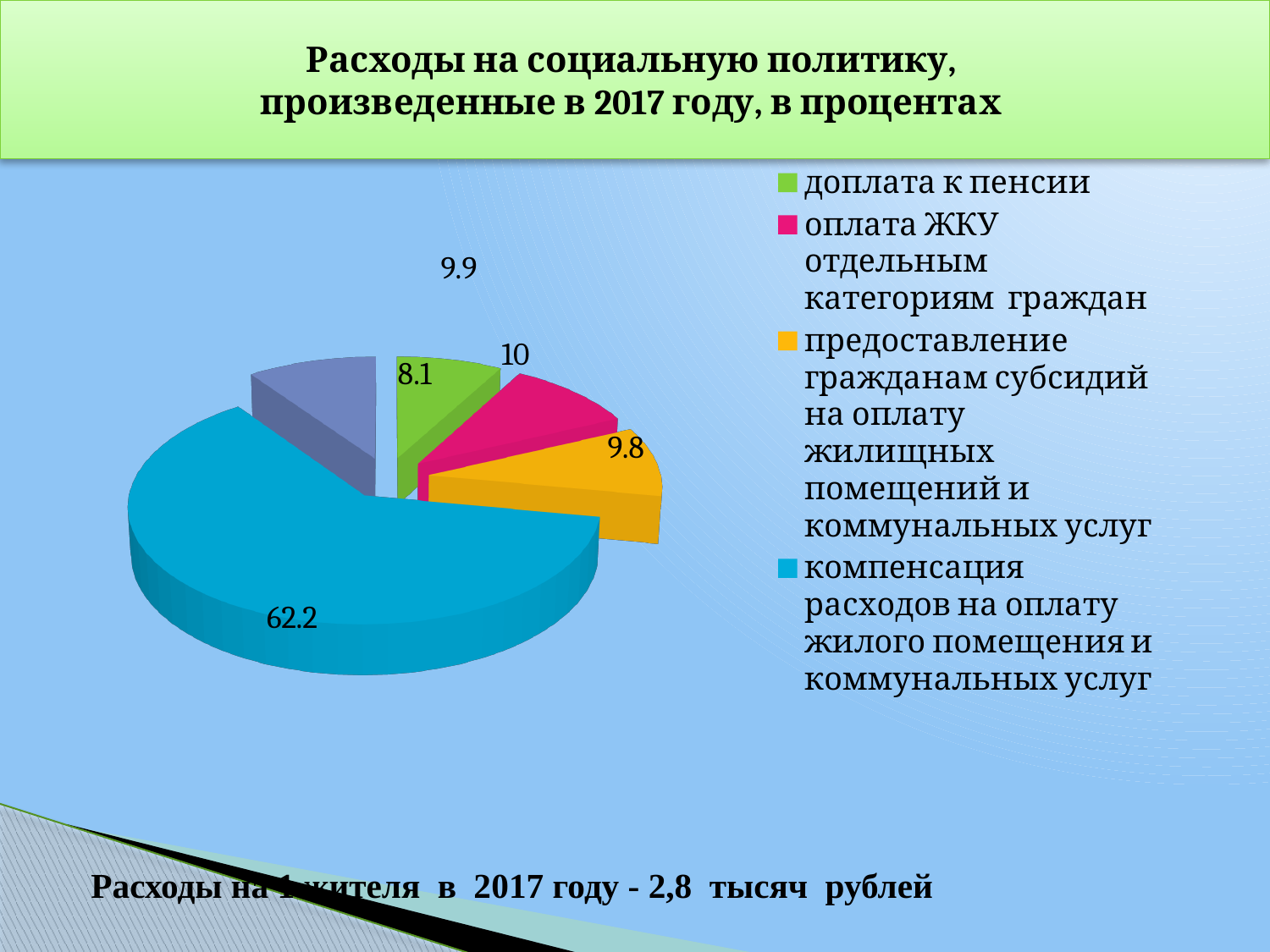
What is the value for оплата ЖКУ отдельным категориям граждан? 10 How many entries does the legend list? 4 How many slices does the pie chart have? 5 Which category has the largest slice of the pie? компенсация расходов на оплату жилого помещения и коммунальных услуг What is the value for предоставление гражданам субсидий на оплату жилищных помещений и коммунальных услуг? 9.8 What kind of chart is shown on the slide? pie chart Which category has the smallest slice of the pie? доплата к пенсии Which is larger: the value for оплата ЖКУ отдельным категориям граждан or the value for доплата к пенсии? оплата ЖКУ отдельным категориям граждан What is the value for компенсация расходов на оплату жилого помещения и коммунальных услуг? 62.2 What colour is the slice for доплата к пенсии? green What is the difference between the values for компенсация расходов на оплату жилого помещения и коммунальных услуг and доплата к пенсии? 54.1 What is the value for доплата к пенсии? 8.1